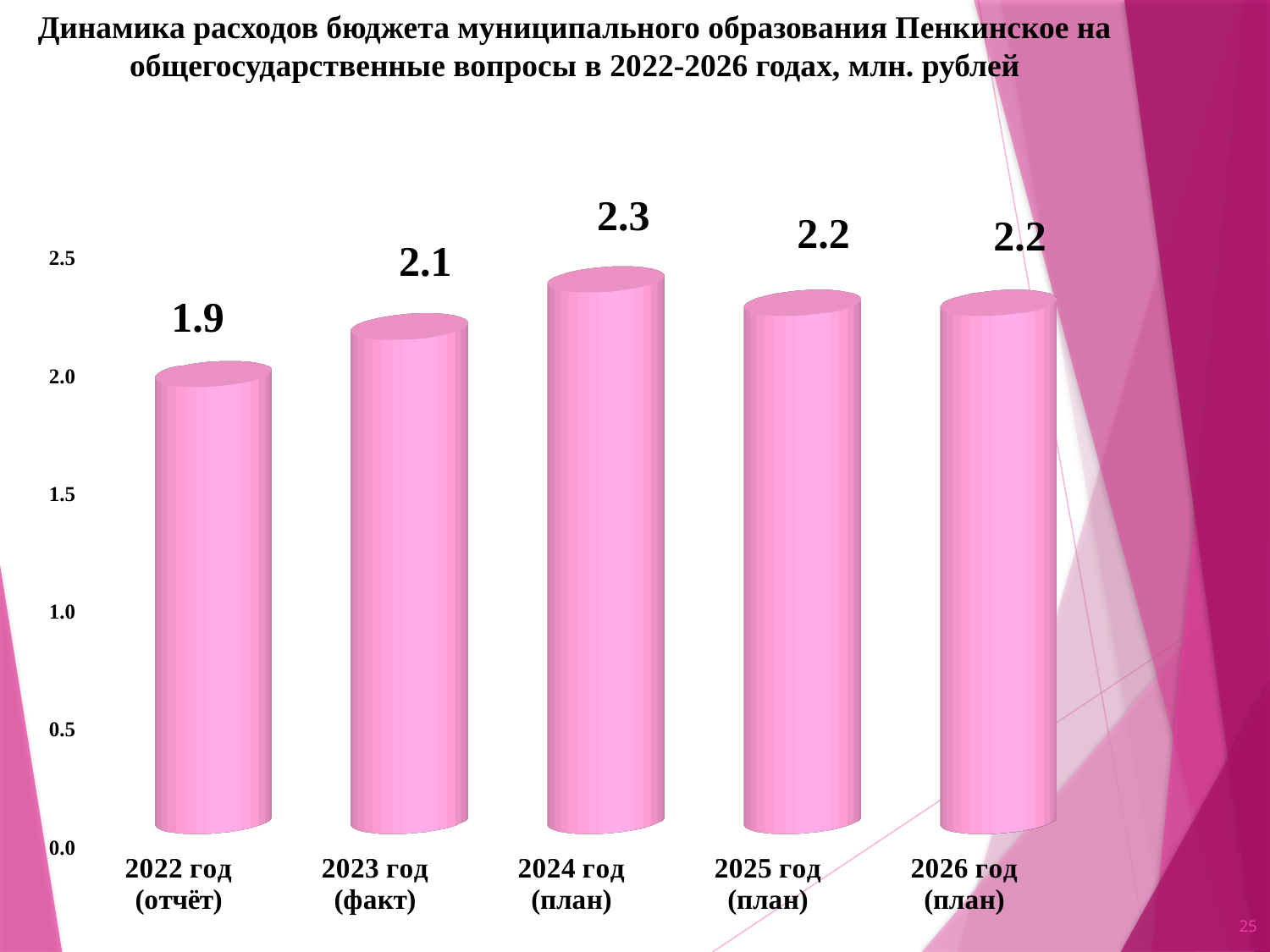
What is the difference between the values for 2024 год (план) and 2022 год (отчёт)? 0.4 Which year has the highest value? 2024 год (план) What is the value for 2022 год (отчёт)? 1.9 Which is larger, the value for 2023 год (факт) or the value for 2025 год (план)? 2025 год (план) In what units are the values on the chart expressed, according to the title? млн. рублей How many years are shown on the chart? 5 Do the values rise or fall from 2022 год (отчёт) to 2024 год (план)? rise Is the value for 2022 год (отчёт) greater or less than 2.0? less Which year has the lowest value? 2022 год (отчёт) What kind of chart is shown on the slide? bar chart What is the value for 2026 год (план)? 2.2 What is the value for 2024 год (план)? 2.3